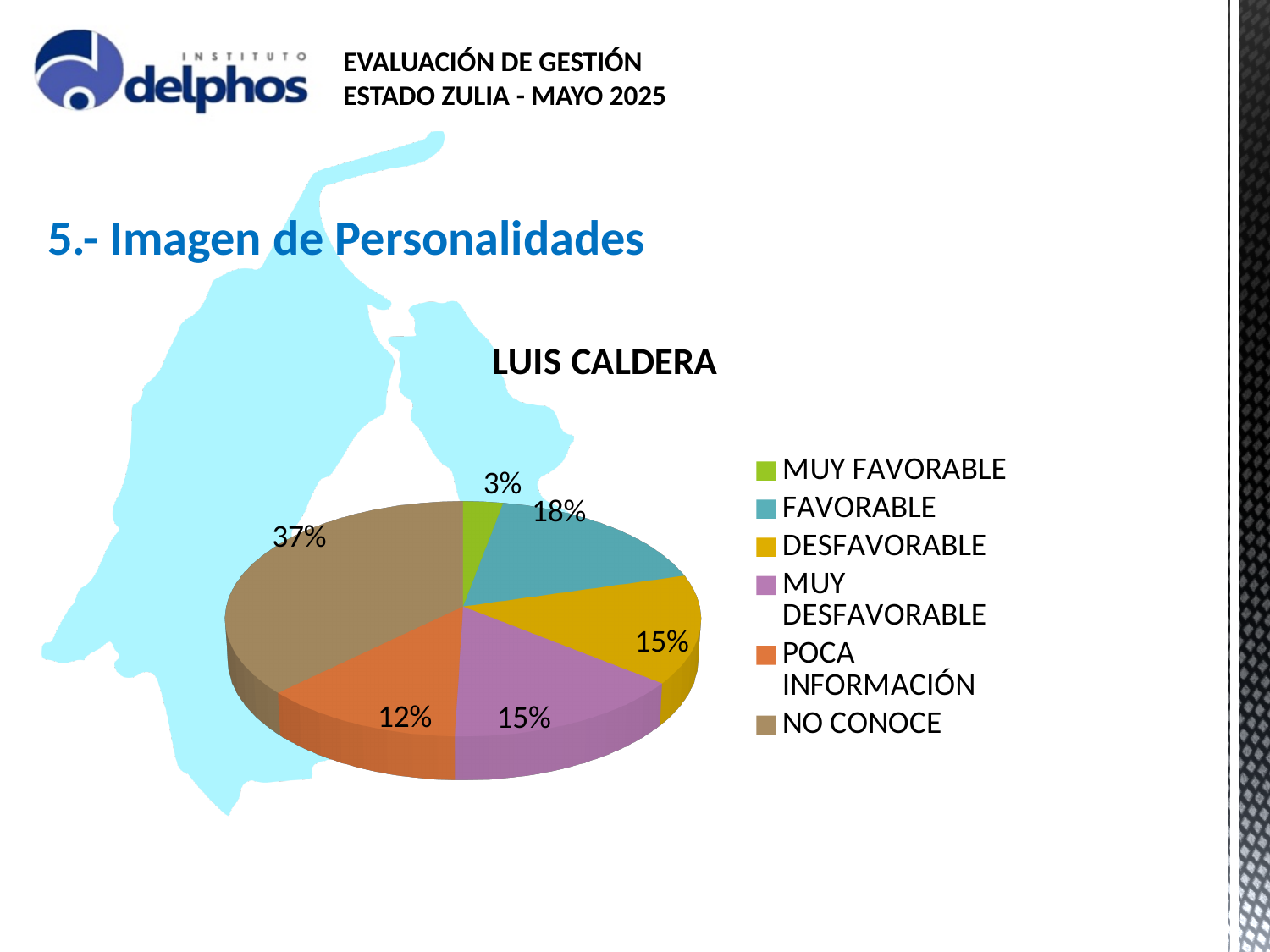
What is the title of the chart? LUIS CALDERA What kind of chart is shown on the slide? pie chart What percentage of the pie is labelled FAVORABLE? 18% What percentage of the pie is labelled POCA INFORMACIÓN? 12% What is the difference in percentage points between NO CONOCE and FAVORABLE? 19 What percentage of the pie is labelled NO CONOCE? 37% Which category has the largest slice of the pie? NO CONOCE How many categories does the legend list? 6 Which category has the smallest slice of the pie? MUY FAVORABLE What percentage of the pie is labelled MUY FAVORABLE? 3% What colour is the NO CONOCE slice in the legend? brown Which is larger, the FAVORABLE slice or the POCA INFORMACIÓN slice? FAVORABLE